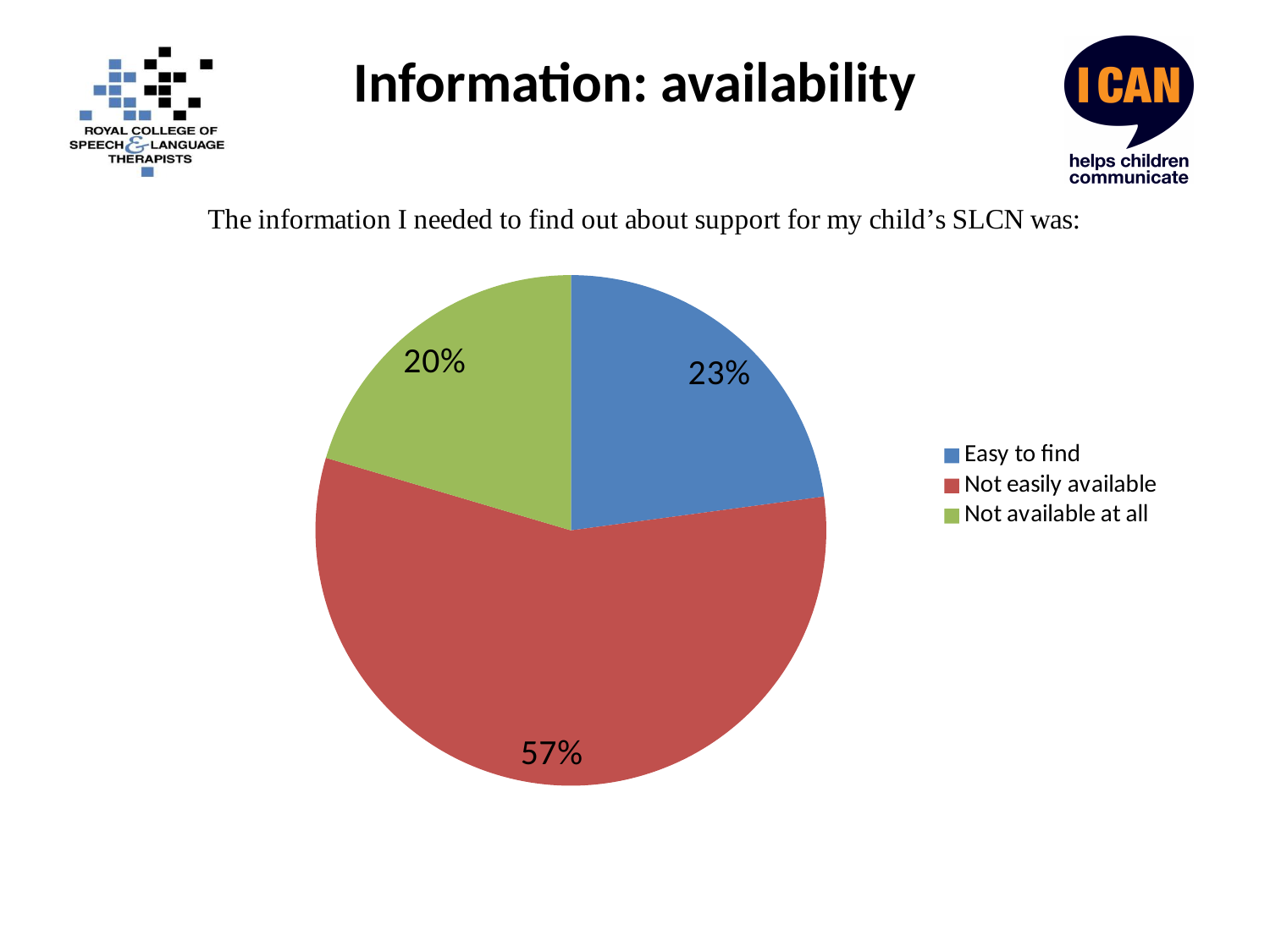
What kind of chart is shown on the slide? pie chart What is the difference in percentage points between 'Not easily available' and 'Easy to find'? 34 Which category has the largest share of the pie? Not easily available What is the title of the slide? Information: availability Which category has the smallest share of the pie? Not available at all What percentage of respondents said the information was not easily available? 57% How many categories does the pie chart show? 3 What percentage of respondents said the information was not available at all? 20% How many entries does the legend list? 3 What colour is the 'Not easily available' slice? red Which is larger: the share for 'Easy to find' or the share for 'Not available at all'? Easy to find What percentage of respondents said the information was easy to find? 23%